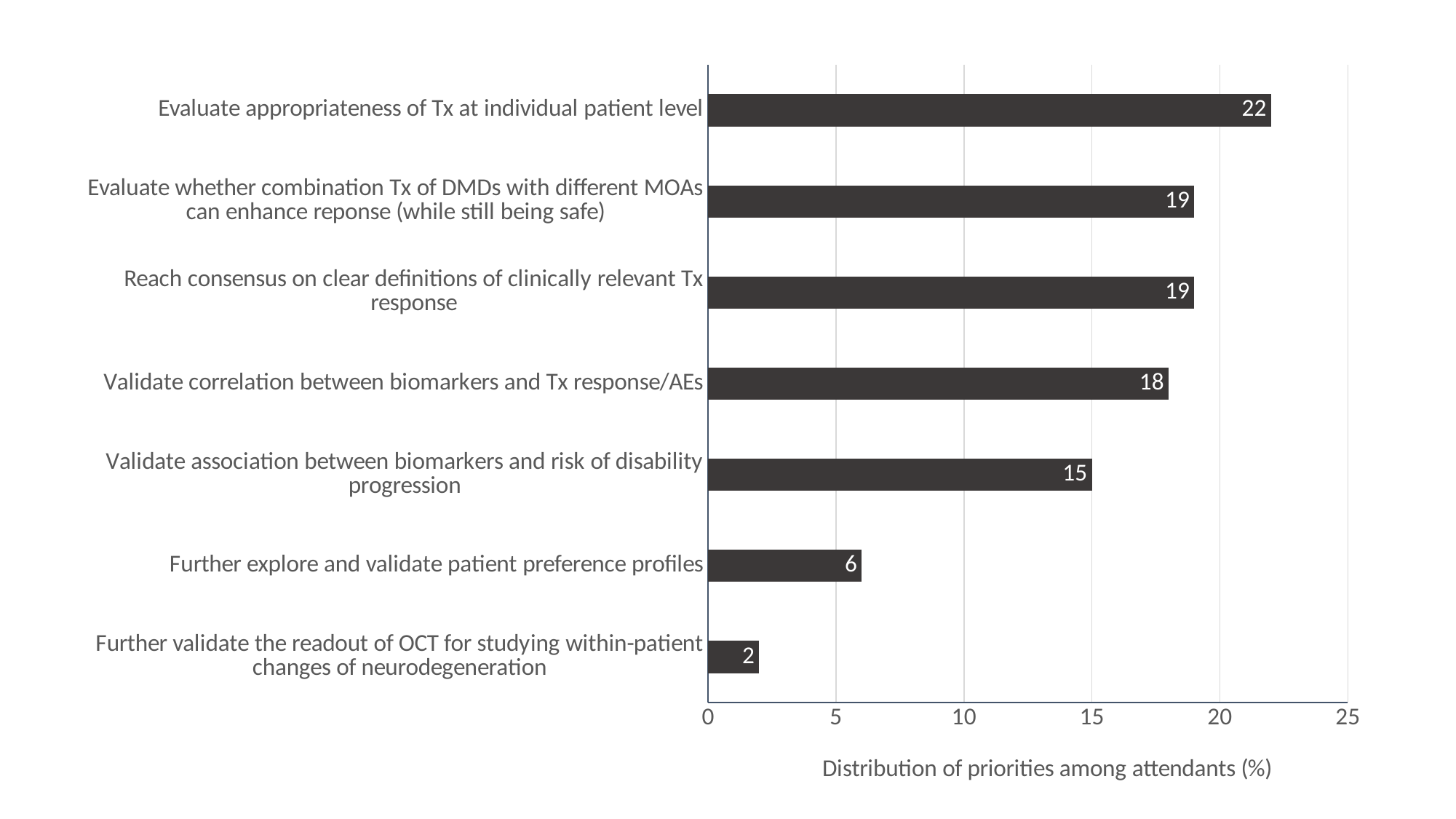
What is the value for "Further validate the readout of OCT for studying within-patient changes of neurodegeneration"? 2 What is the difference between the values for "Evaluate appropriateness of Tx at individual patient level" and "Validate association between biomarkers and risk of disability progression"? 7 What kind of chart is shown on the slide? bar chart Is the value for "Validate association between biomarkers and risk of disability progression" greater or less than 10? greater Which category has the highest value? Evaluate appropriateness of Tx at individual patient level Which is larger: the value for "Validate correlation between biomarkers and Tx response/AEs" or the value for "Further explore and validate patient preference profiles"? Validate correlation between biomarkers and Tx response/AEs What is the label of the horizontal axis? Distribution of priorities among attendants (%) What is the value for "Further explore and validate patient preference profiles"? 6 What is the value for "Validate correlation between biomarkers and Tx response/AEs"? 18 How many categories are shown in the chart? 7 Which category has the lowest value? Further validate the readout of OCT for studying within-patient changes of neurodegeneration What is the value for "Evaluate appropriateness of Tx at individual patient level"? 22